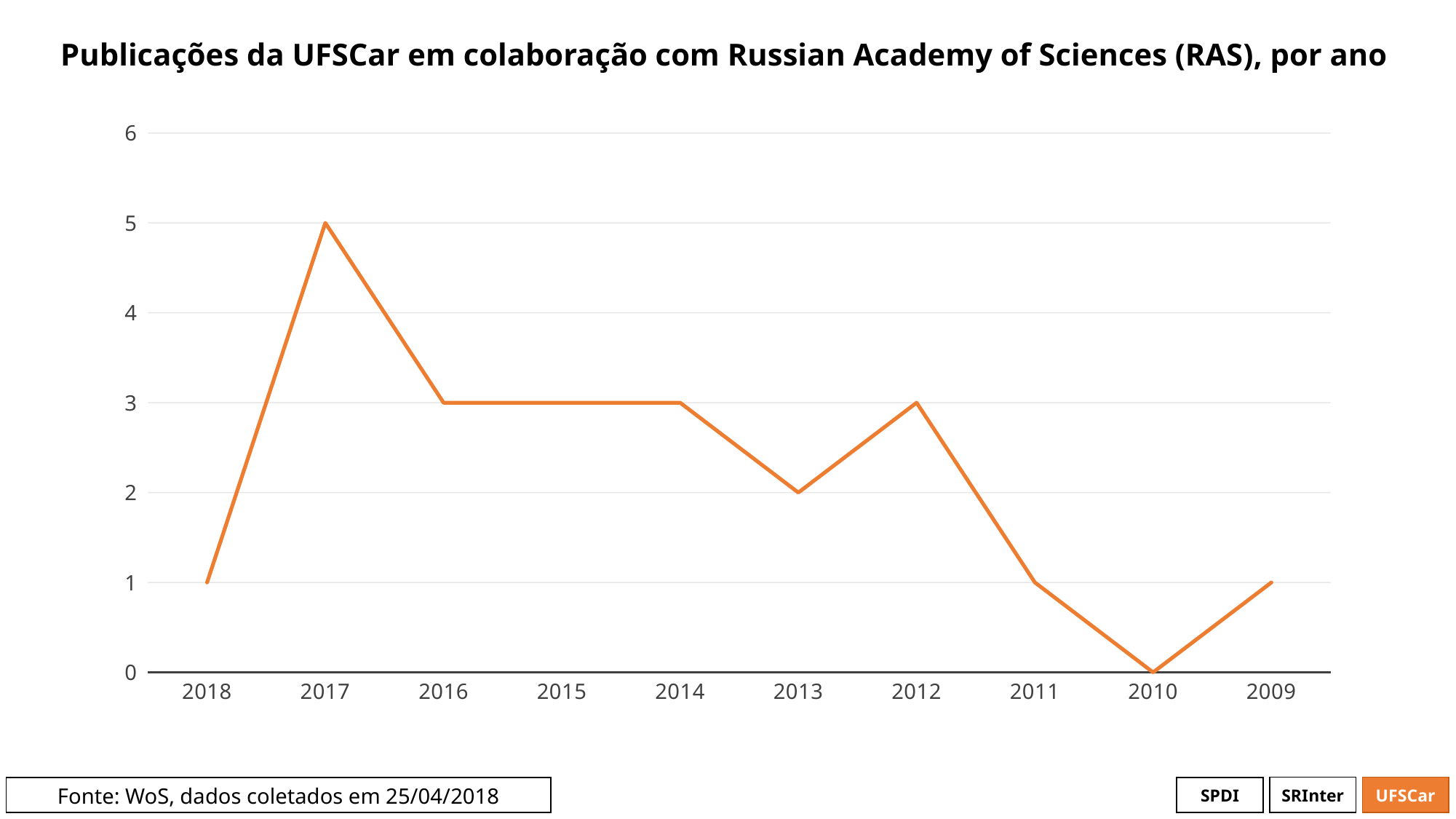
Which year has the lowest number of publications? 2010 Which year has the highest number of publications? 2017 What is the difference between the values for 2017 and 2016? 2 What is the value for 2010? 0 What is the value for 2013? 2 Which year has a larger value, 2012 or 2011? 2012 What is the title of the chart? Publicações da UFSCar em colaboração com Russian Academy of Sciences (RAS), por ano How many publications are shown for 2017? 5 How many years are plotted on the x axis? 10 Is the value for 2017 greater or less than 4? greater What is the value for 2018? 1 What type of chart is shown on the slide? line chart